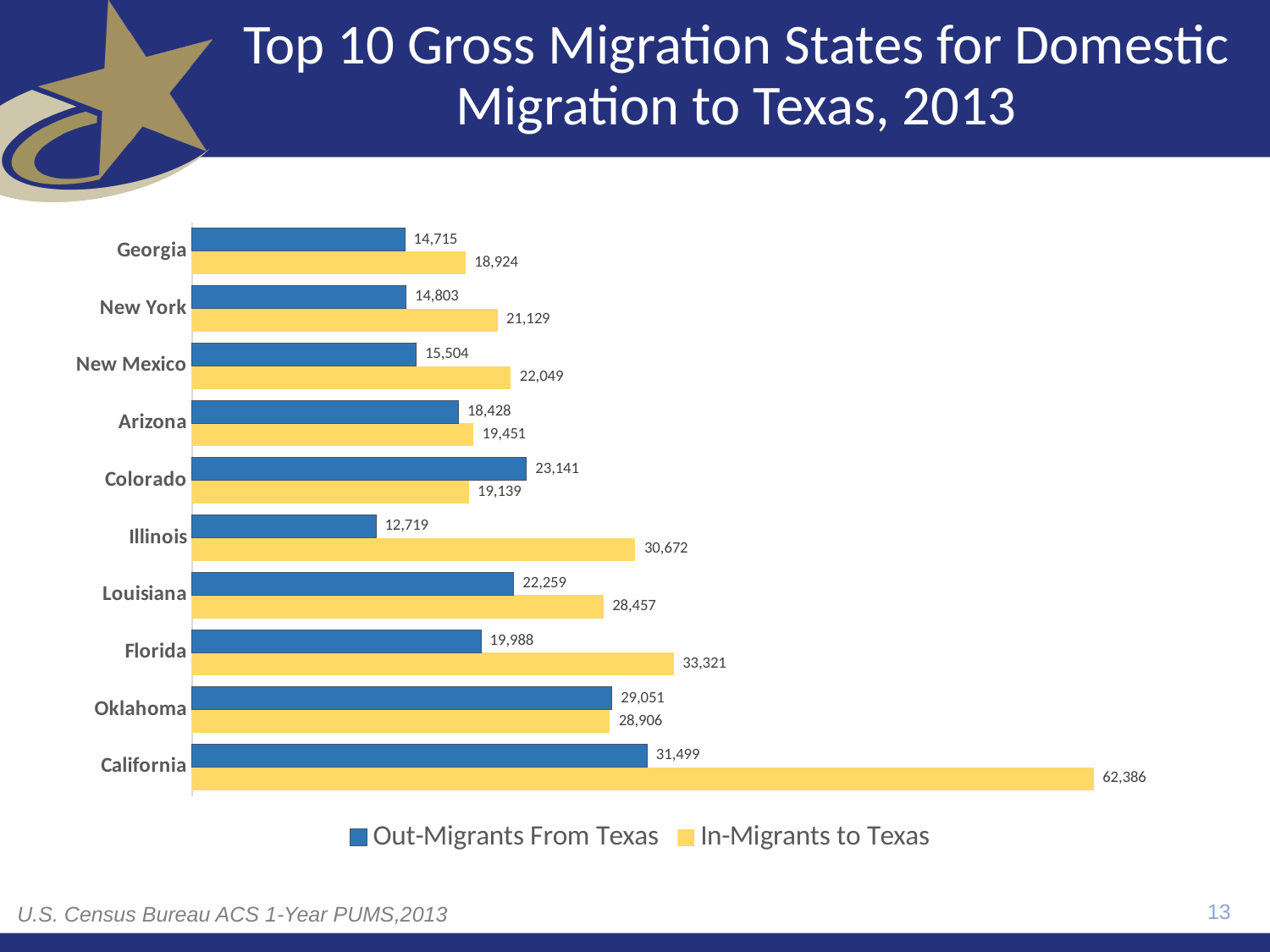
Which state has the highest number of In-Migrants to Texas? California What is the number of In-Migrants to Texas from California? 62,386 What is the number of Out-Migrants From Texas to Illinois? 12,719 How many states are shown in the chart? 10 What kind of chart is shown on the slide? Bar chart What is the difference between In-Migrants to Texas and Out-Migrants From Texas for Illinois? 17,953 For Colorado, which is larger: Out-Migrants From Texas or In-Migrants to Texas? Out-Migrants From Texas Which state has the lowest number of Out-Migrants From Texas? Illinois Which colour represents In-Migrants to Texas in the chart? Yellow What is the total of Out-Migrants From Texas and In-Migrants to Texas for Oklahoma? 57,957 How many series does the legend list? 2 What is the number of In-Migrants to Texas from Florida? 33,321